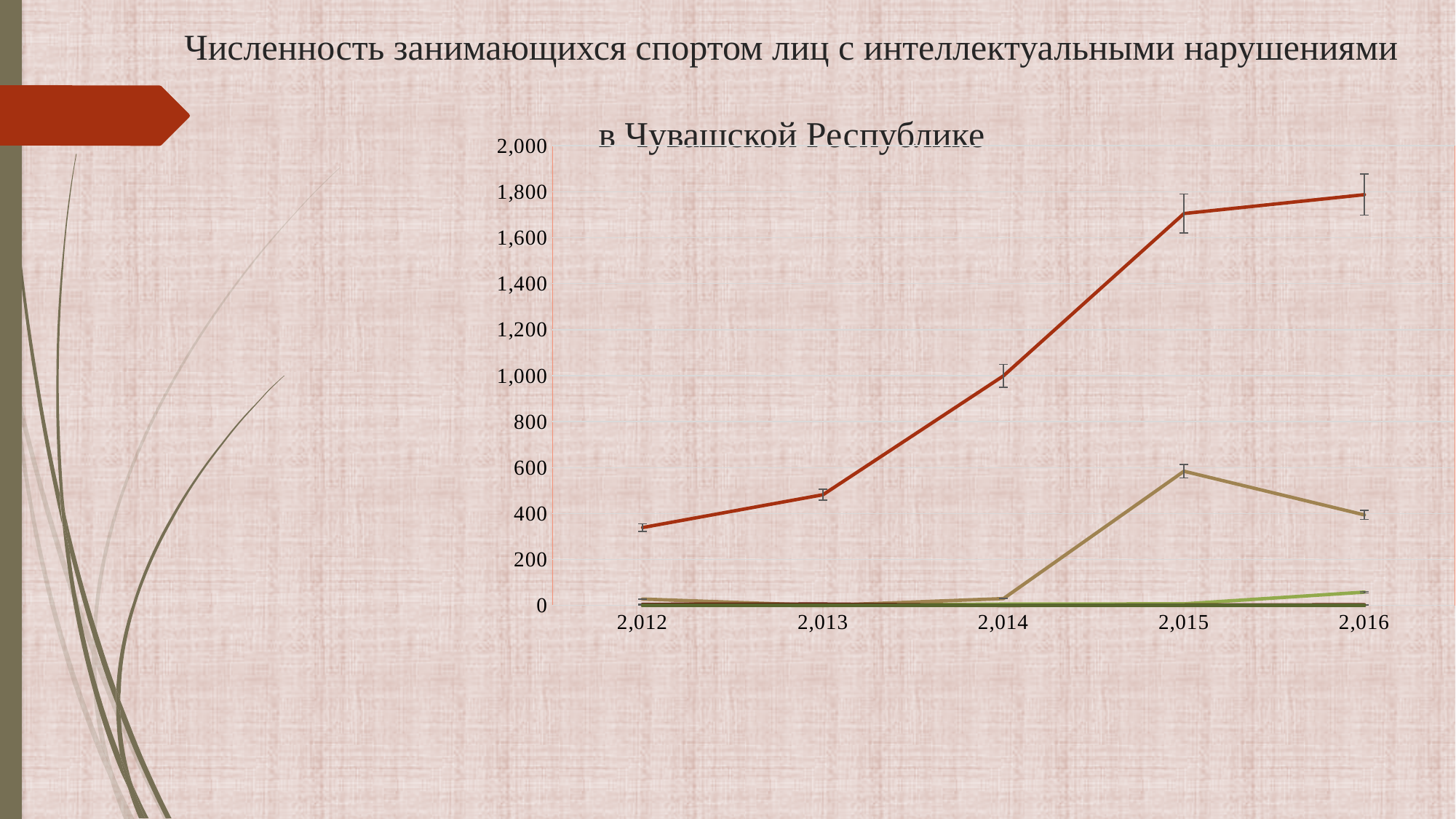
Is the value of the red line in 2,013 greater or less than 600? less Is the value of the red line in 2,015 greater or less than 1,600? greater How many years are shown along the x axis of the chart? 5 In 2,015, which line has the larger value, the red line or the tan (brown) line? the red line Is the value of the tan (brown) line in 2,015 greater or less than 400? greater In which year does the tan (brown) line reach its highest value? 2,015 What is the first year shown on the x axis of the chart? 2,012 Does the red line rise or fall from 2,012 to 2,016? rises What kind of chart is shown on the slide? line chart What is the last year shown on the x axis of the chart? 2,016